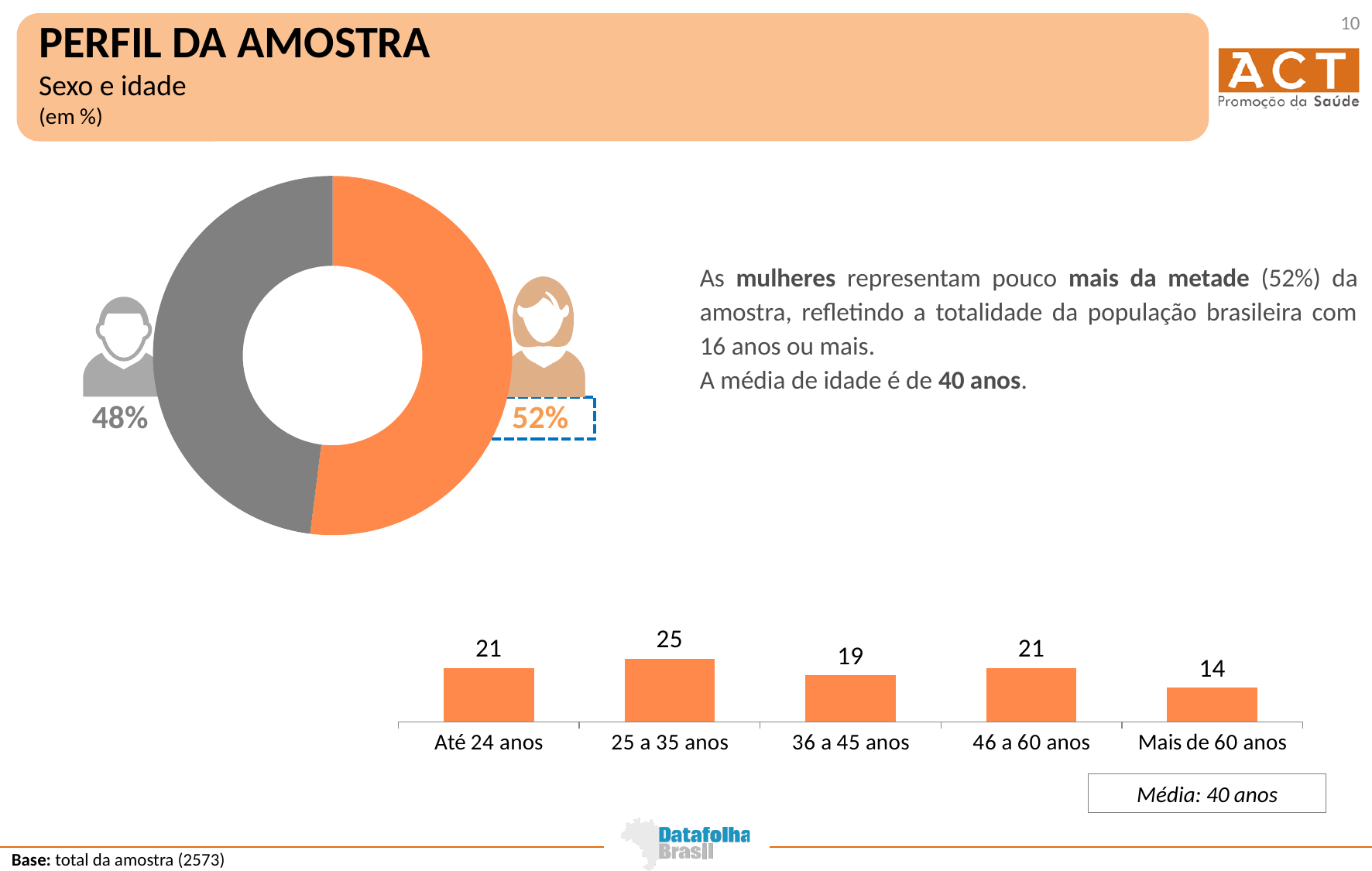
In the donut chart on the left, which is larger, the share of men or the share of women? women In the donut chart on the left, what is the difference between the women's share and the men's share? 4 percentage points What kind of chart is the chart on the left showing sex? donut (pie) chart In the donut chart on the left, what share of the sample is women (52% label)? 52% In the bar chart at the bottom, what is the difference between '25 a 35 anos' and '36 a 45 anos'? 6 In the bar chart at the bottom, what is the value for 'Mais de 60 anos'? 14 How many age groups are shown in the bar chart at the bottom? 5 In the bar chart at the bottom, which age group has the highest value? 25 a 35 anos In the bar chart at the bottom, what is the value for '25 a 35 anos'? 25 What kind of chart is the chart at the bottom showing age groups? bar chart In the bar chart at the bottom, which age group has the lowest value? Mais de 60 anos In the donut chart on the left, what share of the sample is men? 48%